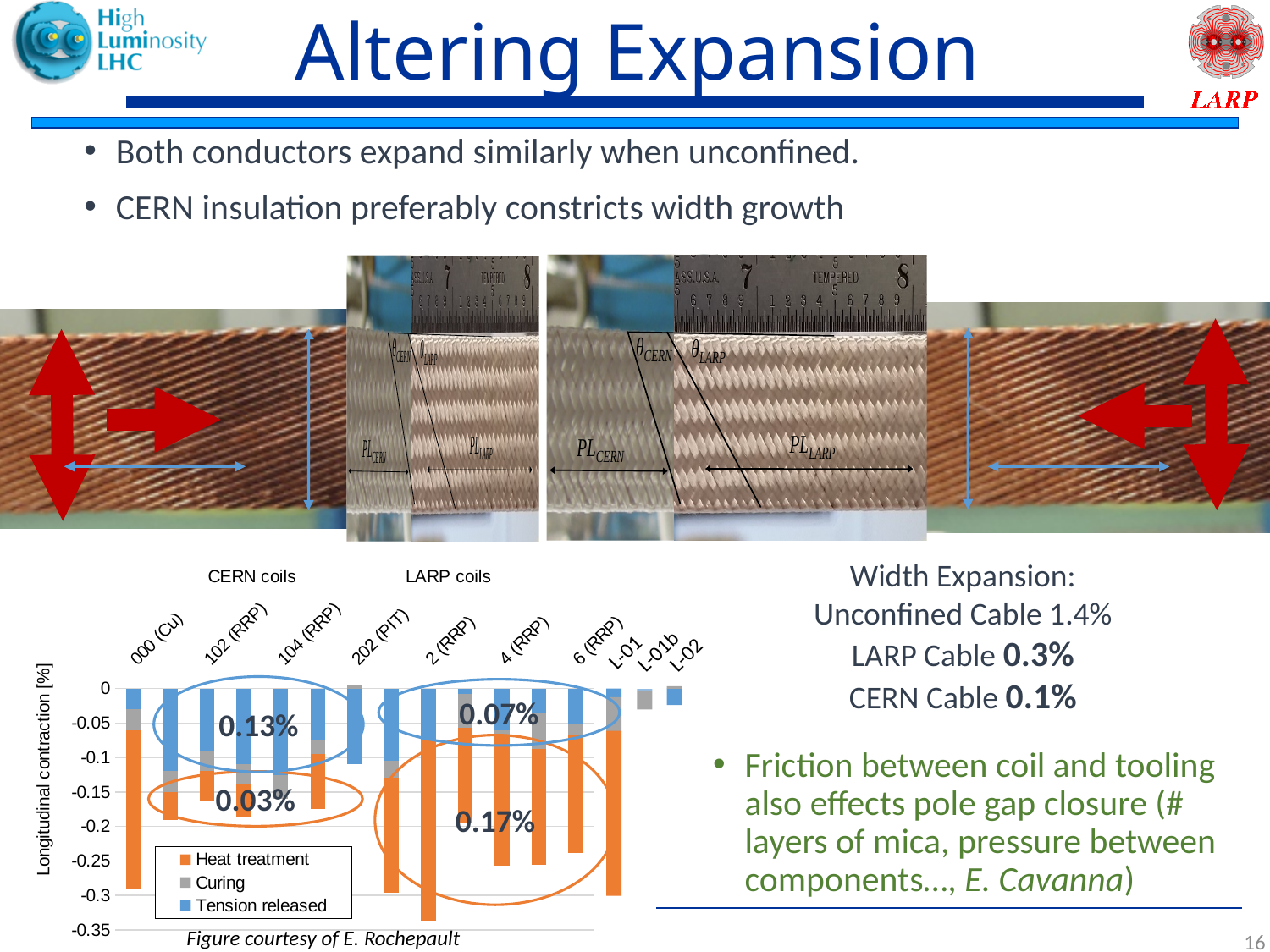
How many series does the legend of the longitudinal contraction chart list? 3 In the longitudinal contraction chart, is the Heat treatment value for 102 (RRP) greater or less than -0.15? greater In the longitudinal contraction chart, is the Heat treatment value for 2 (RRP) greater or less than -0.3? greater What kind of chart is shown at the bottom left of the slide? bar chart In the longitudinal contraction chart, which shows a larger Heat treatment contraction: 000 (Cu) or 102 (RRP)? 000 (Cu) In the longitudinal contraction chart, which category has the largest Heat treatment contraction (longest orange bar)? 2 (RRP) What are the three series listed in the legend of the longitudinal contraction chart? Heat treatment, Curing, Tension released What is the y-axis label of the bar chart? Longitudinal contraction [%]